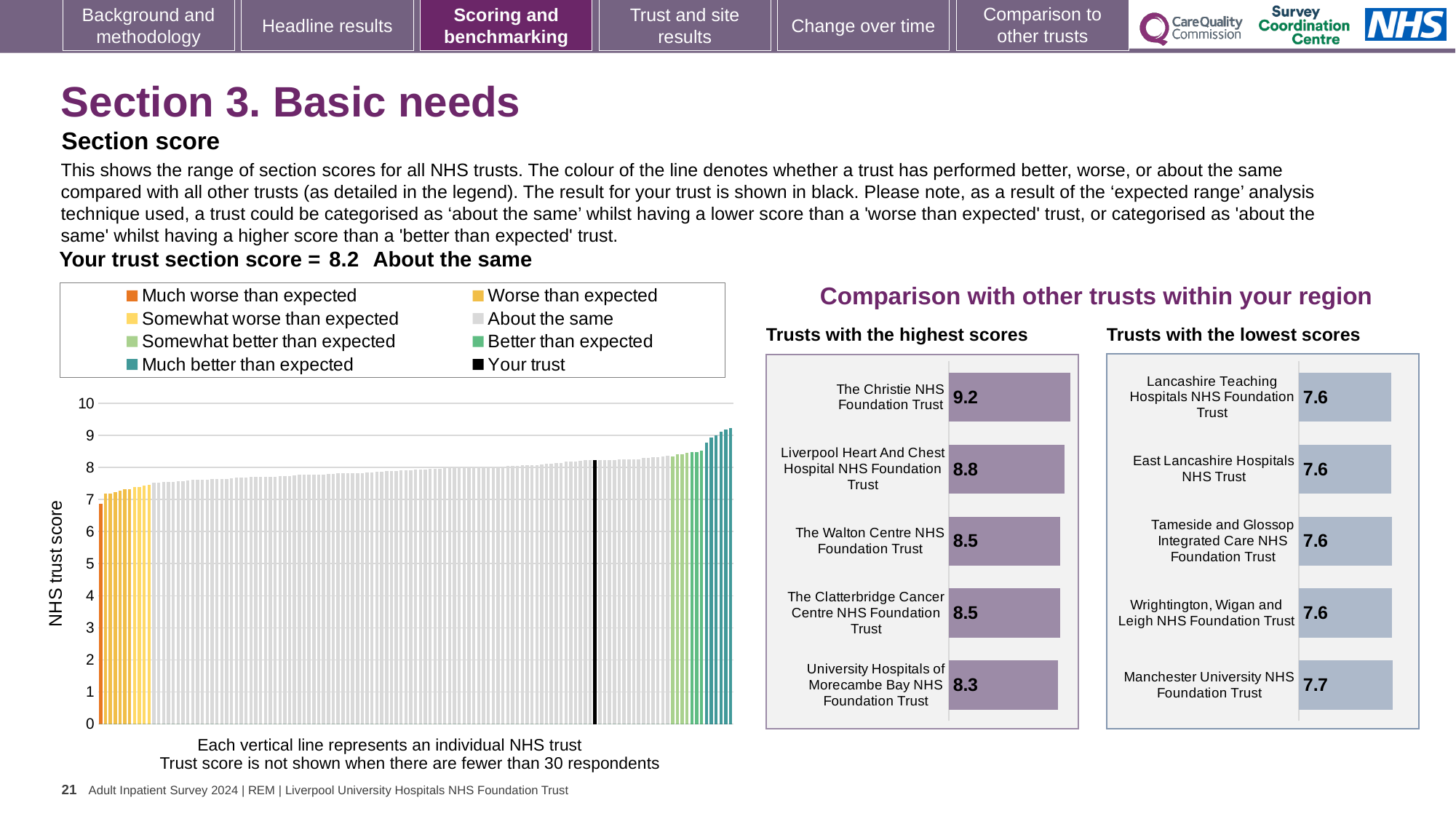
In the 'Trusts with the lowest scores' chart, how many trusts are listed? 5 In the 'Trusts with the highest scores' chart, what is the score for The Christie NHS Foundation Trust? 9.2 In the 'Trusts with the highest scores' chart, what is the score for University Hospitals of Morecambe Bay NHS Foundation Trust? 8.3 In the 'Trusts with the highest scores' chart, what is the difference between the scores of The Christie NHS Foundation Trust and Liverpool Heart And Chest Hospital NHS Foundation Trust? 0.4 In the 'Trusts with the highest scores' chart, which has the larger score: The Walton Centre NHS Foundation Trust or University Hospitals of Morecambe Bay NHS Foundation Trust? The Walton Centre NHS Foundation Trust What kind of chart is the 'NHS trust score' chart on the left of the slide? Bar chart In the 'NHS trust score' chart on the left, do the trust scores rise or fall from left to right along the x axis? Rise In the 'NHS trust score' chart on the left, what is the section score for your trust? 8.2 In the 'Trusts with the lowest scores' chart, what is the score for Manchester University NHS Foundation Trust? 7.7 In the 'Trusts with the highest scores' chart, which trust has the highest score? The Christie NHS Foundation Trust How many entries does the legend of the 'NHS trust score' chart on the left list? 8 In the 'Trusts with the lowest scores' chart, which trust has the highest score? Manchester University NHS Foundation Trust